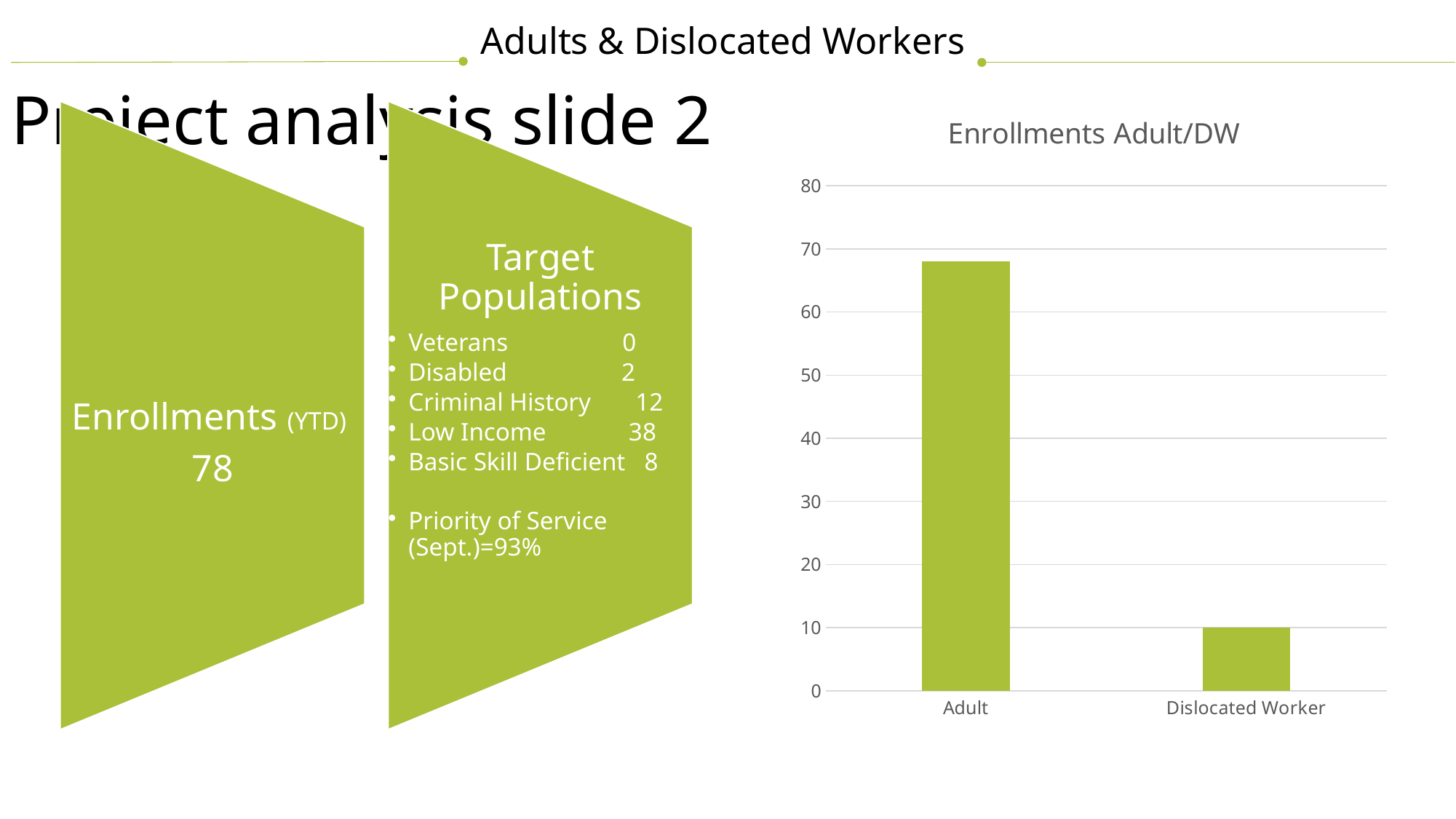
How many categories are shown on the x axis of the chart? 2 Do the values rise or fall from Adult to Dislocated Worker along the x axis? fall Is the value for Adult greater or less than 60? greater Which category has the lowest value in the chart? Dislocated Worker What is the title of the chart? Enrollments Adult/DW Which category has the highest value in the chart? Adult What is the highest value shown on the chart's vertical axis? 80 Is the value for Adult greater or less than 70? less What is the value for Dislocated Worker in the chart? 10 What type of chart is shown on the slide? bar chart Which is larger, the value for Adult or the value for Dislocated Worker? Adult